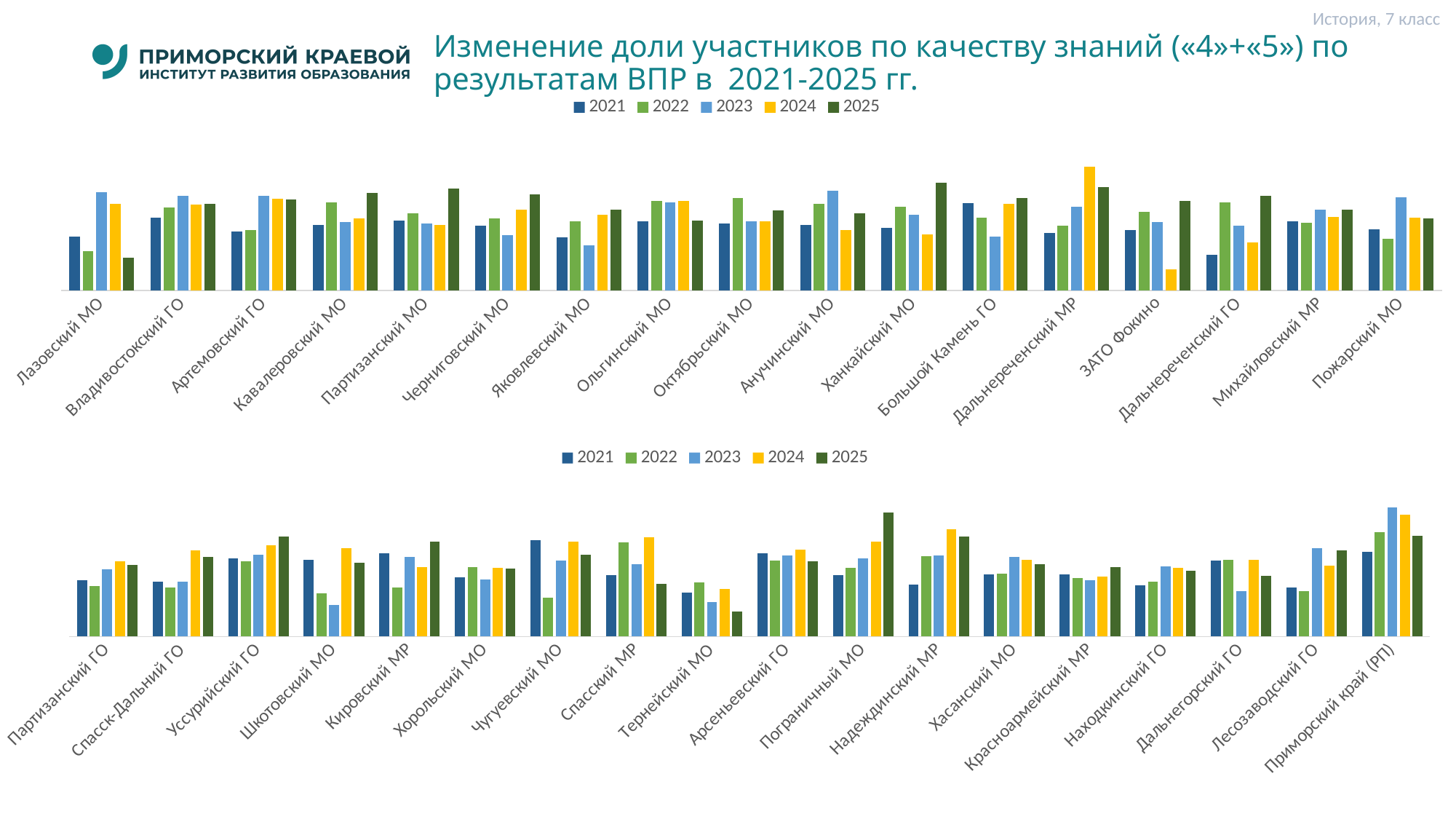
In the bottom chart, which year has the highest bar for Приморский край (РП)? 2023 In the bottom chart, for Шкотовский МО, which is larger: the 2023 bar or the 2024 bar? 2024 How many series does the legend of the top chart list? 5 In the top chart, which year has the lowest bar for ЗАТО Фокино? 2024 Which years are listed in the legend of the bottom chart? 2021, 2022, 2023, 2024, 2025 In the bottom chart, which year has the highest bar for Пограничный МО? 2025 How many categories are shown on the x axis of the bottom chart? 18 In the bottom chart, which year has the lowest bar for Тернейский МО? 2025 In the top chart, which year has the highest bar for Лазовский МО? 2023 How many categories are shown on the x axis of the top chart? 17 What kind of chart is the top chart on the slide? bar chart